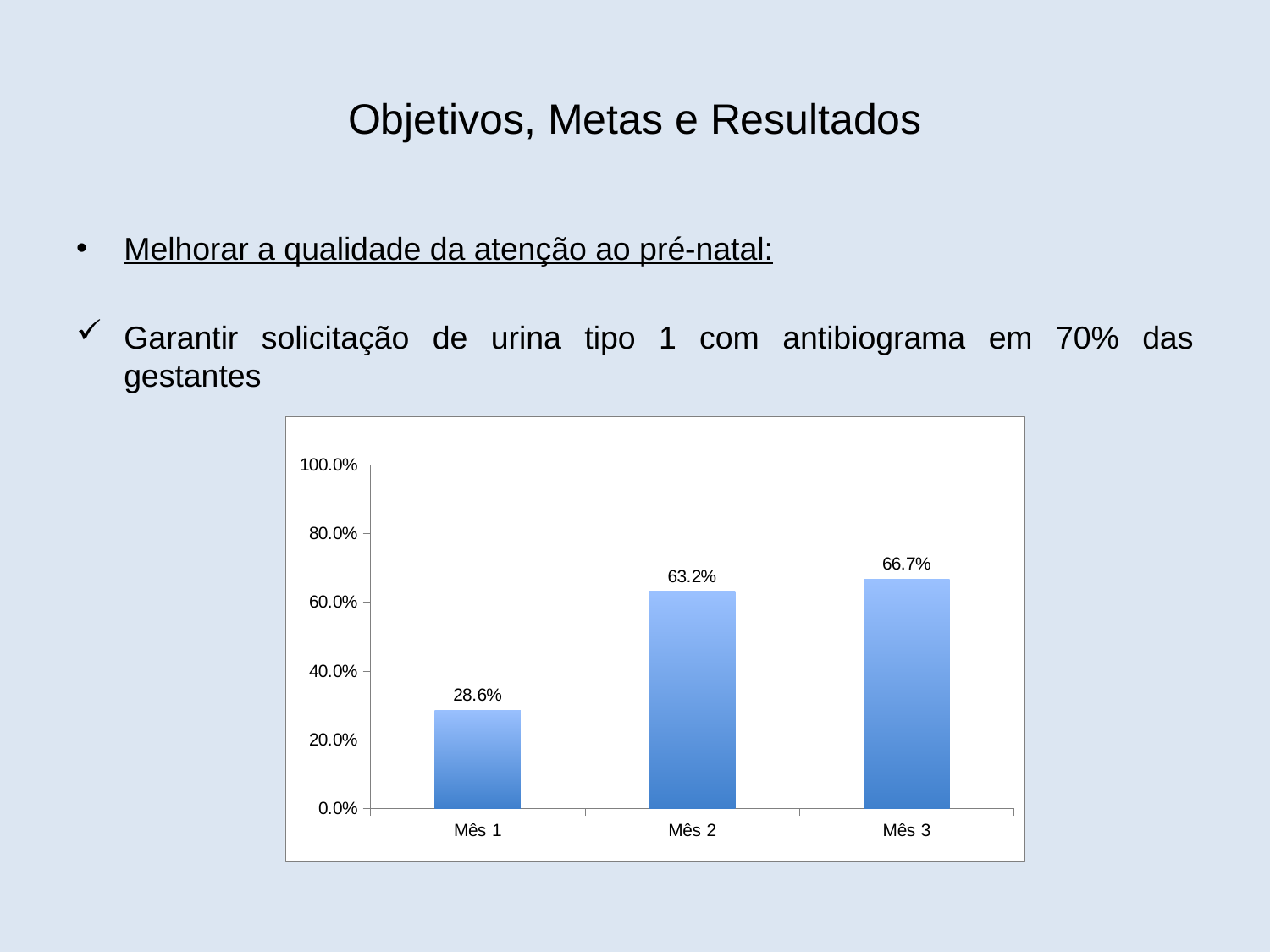
What is the difference between the values for Mês 2 and Mês 1? 34.6% What kind of chart is shown on the slide? bar chart How many months are shown on the x axis? 3 Do the values rise or fall from Mês 1 to Mês 3? rise Which is larger, the value for Mês 1 or the value for Mês 2? Mês 2 Is the value for Mês 3 greater or less than 80.0%? less Which month has the lowest value? Mês 1 What is the value for Mês 2? 63.2% What is the value for Mês 3? 66.7% What is the difference between the values for Mês 3 and Mês 2? 3.5% What is the value for Mês 1? 28.6% Which month has the highest value? Mês 3